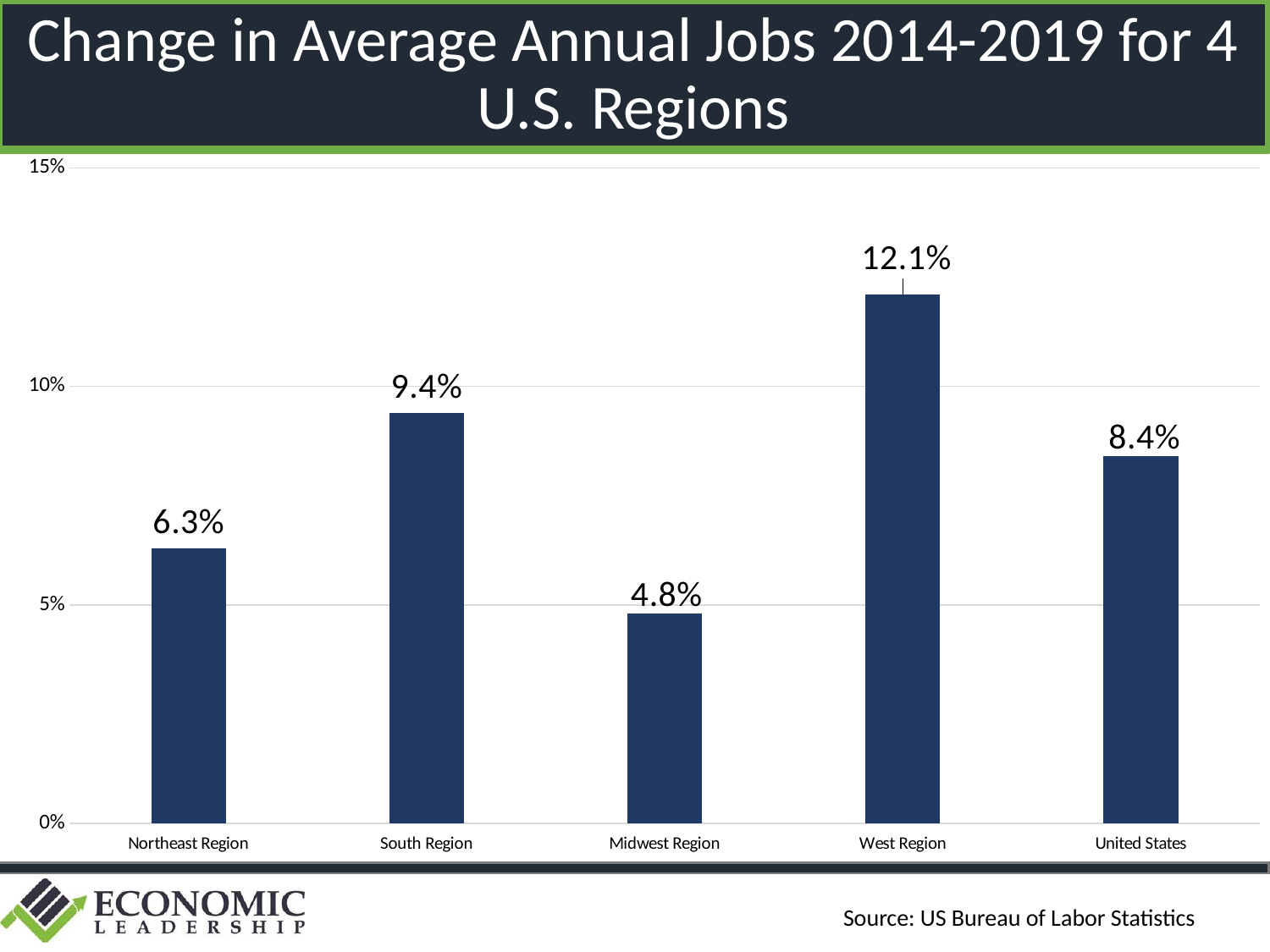
Which category has the lowest value? Midwest Region Which category has the highest value? West Region What is the value shown for the Midwest Region? 4.8% Is the value for the Northeast Region greater or less than 5%? greater What is the difference between the South Region and the Northeast Region values? 3.1% What is the value shown for the United States bar? 8.4% How many categories are shown on the x axis? 5 What is the difference between the West Region and the Midwest Region values? 7.3% Which is larger, the value for the South Region or the value for the United States? South Region What is the title of the chart? Change in Average Annual Jobs 2014-2019 for 4 U.S. Regions What is the change in average annual jobs for the West Region? 12.1% What kind of chart is shown on the slide? Bar chart